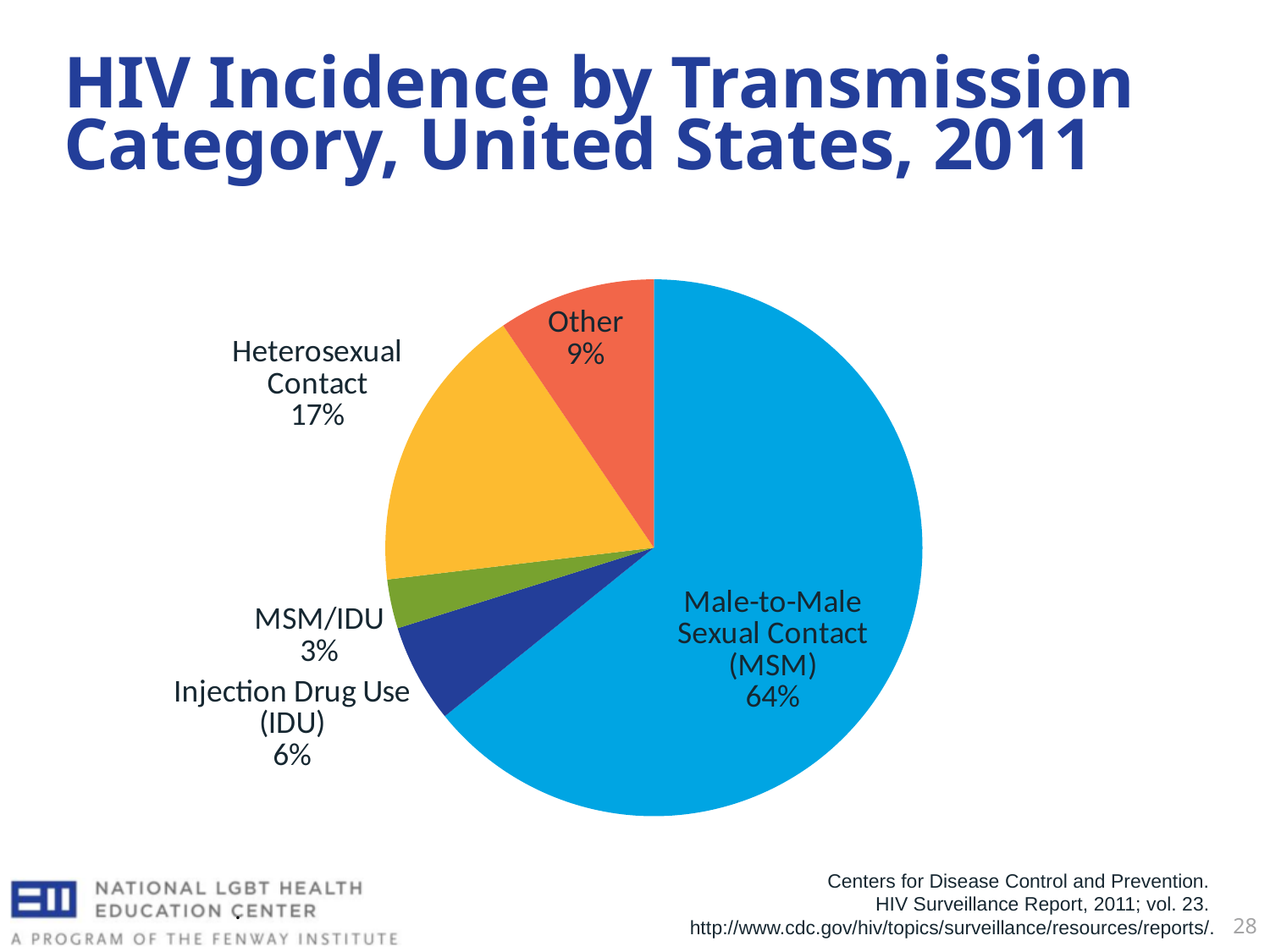
What share of HIV incidence is attributed to Heterosexual Contact? 17% What share of HIV incidence is attributed to Injection Drug Use (IDU)? 6% How many transmission categories are shown in the pie chart? 5 Which is larger, the share for Injection Drug Use (IDU) or the share for Other? Other What kind of chart is shown on the slide? Pie chart What is the difference in percentage points between Heterosexual Contact and Other? 8 What is the title of the chart on the slide? HIV Incidence by Transmission Category, United States, 2011 What share of HIV incidence is attributed to Male-to-Male Sexual Contact (MSM)? 64% What share of HIV incidence is attributed to the Other category? 9% Which transmission category has the largest share of HIV incidence? Male-to-Male Sexual Contact (MSM) Which transmission category has the smallest share of HIV incidence? MSM/IDU What share of HIV incidence is attributed to MSM/IDU? 3%